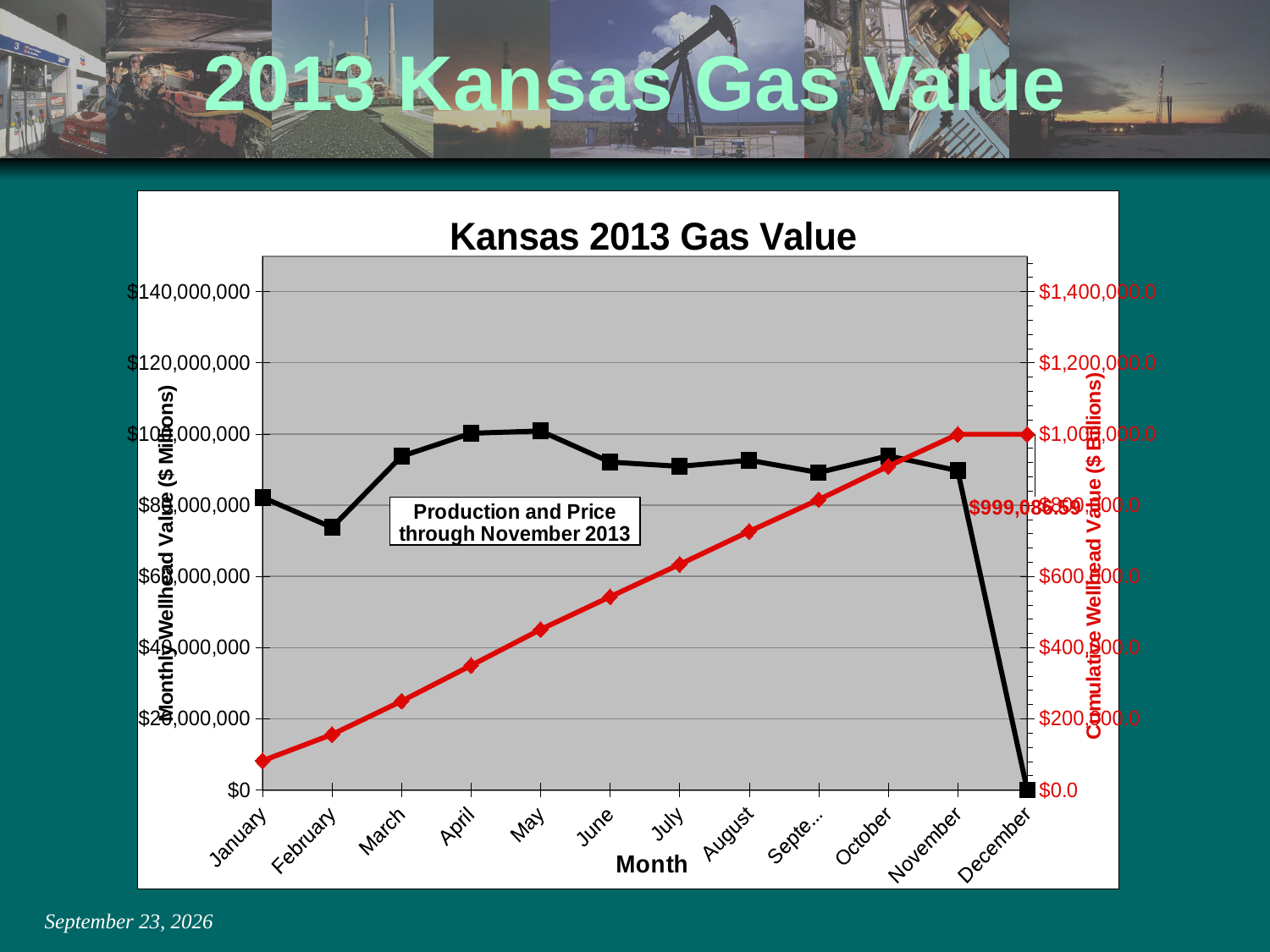
How many lines are plotted on the chart? 2 Does the red line rise or fall from January to November? rise On the black line, which is larger: the value for February or the value for September? September What is the value of the black line for December? $0 What is the title of the chart? Kansas 2013 Gas Value Which month has the lowest value on the black line? December What kind of chart is shown on the slide? line chart How many months are shown along the x axis of the chart? 12 Is the value of the red line for August greater or less than $600,000.0? greater Is the value of the red line for January greater or less than $200,000.0? less Is the value of the black line for February greater or less than $80,000,000? less